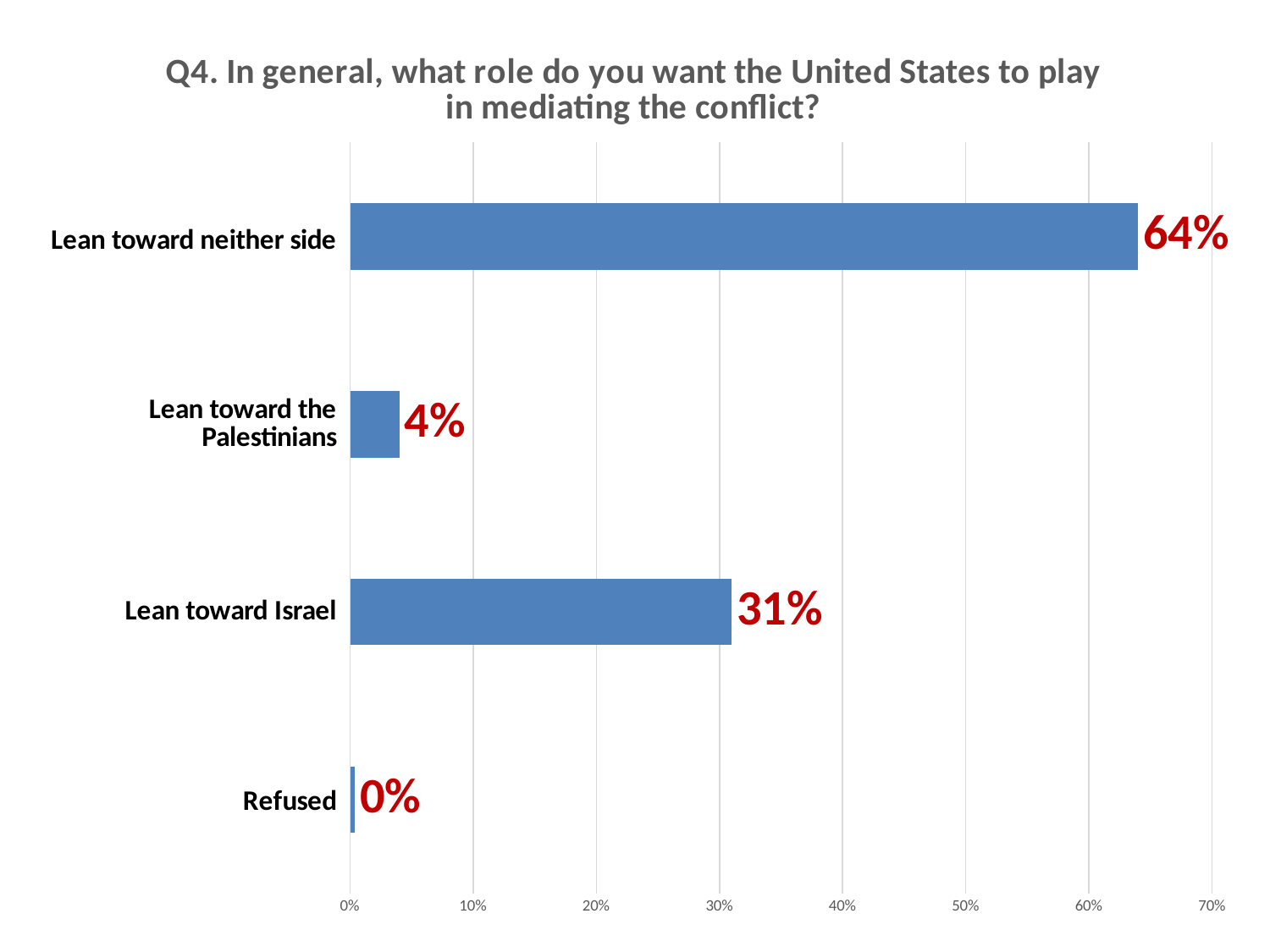
What is the value for 'Refused'? 0% What is the difference between 'Lean toward neither side' and 'Lean toward Israel'? 33% Which is larger: 'Lean toward Israel' or 'Lean toward the Palestinians'? Lean toward Israel What kind of chart is shown on the slide? Bar chart What is the value for 'Lean toward Israel'? 31% What is the value for 'Lean toward the Palestinians'? 4% Which category has the highest value? Lean toward neither side Which category has the lowest value? Refused What is the title of the chart? Q4. In general, what role do you want the United States to play in mediating the conflict? Is the value for 'Lean toward neither side' greater or less than 60%? greater How many categories are shown in the chart? 4 What percentage of respondents want the United States to lean toward neither side? 64%